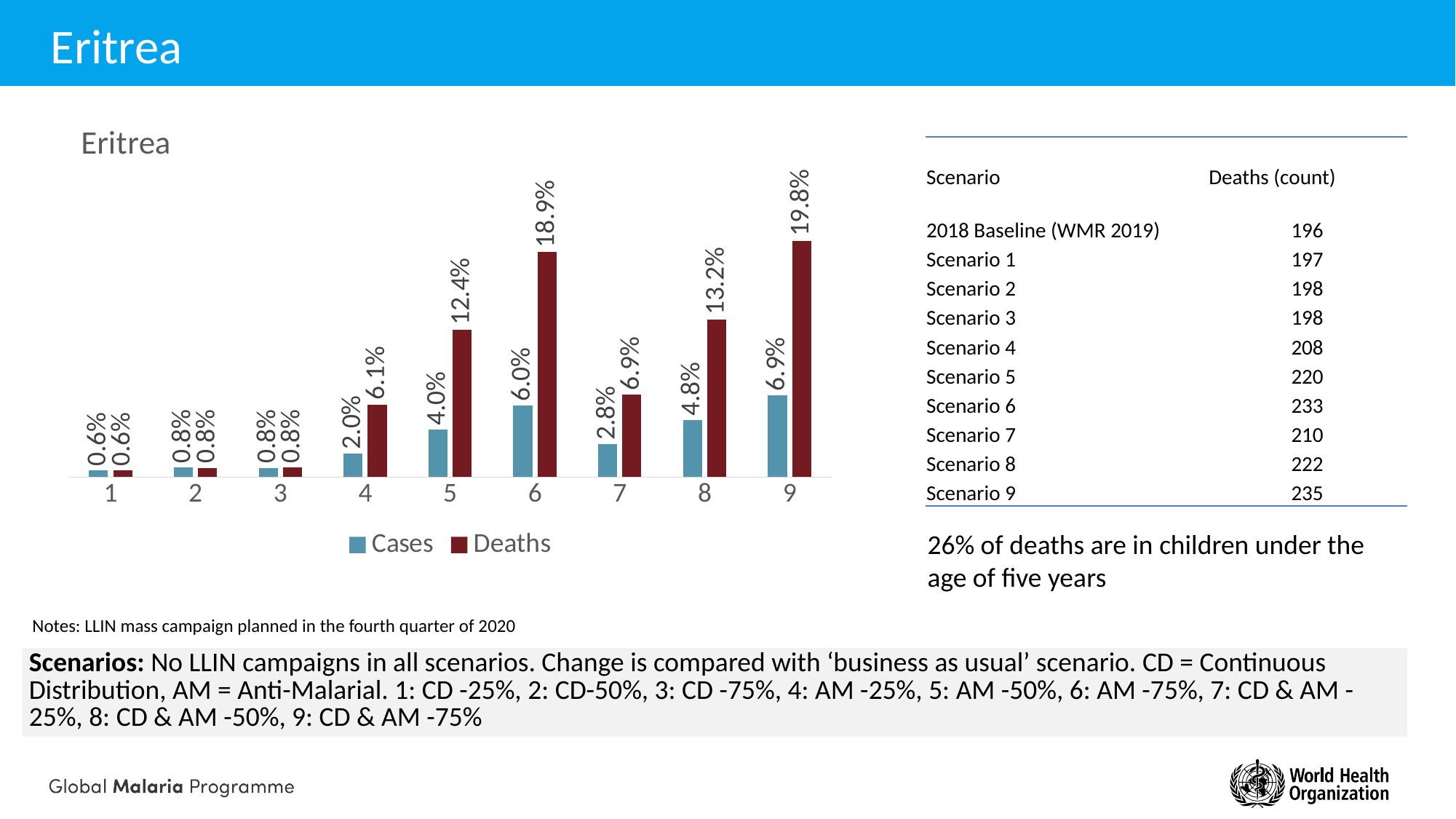
What is the Deaths value for scenario 6? 18.9% Which is larger: the Deaths value for scenario 5 or the Deaths value for scenario 7? Scenario 5 What is the difference between the Deaths value and the Cases value for scenario 8? 8.4% What is the title of the chart? Eritrea What is the Cases value for scenario 9? 6.9% How many scenarios are shown on the x axis of the chart? 9 Which scenario has the lowest Cases value? 1 What is the Cases value for scenario 5? 4.0% Which scenario has the highest Deaths value? 9 What kind of chart is shown on the slide? Bar chart How many series does the chart legend list? 2 Which series is shown in dark red in the chart? Deaths